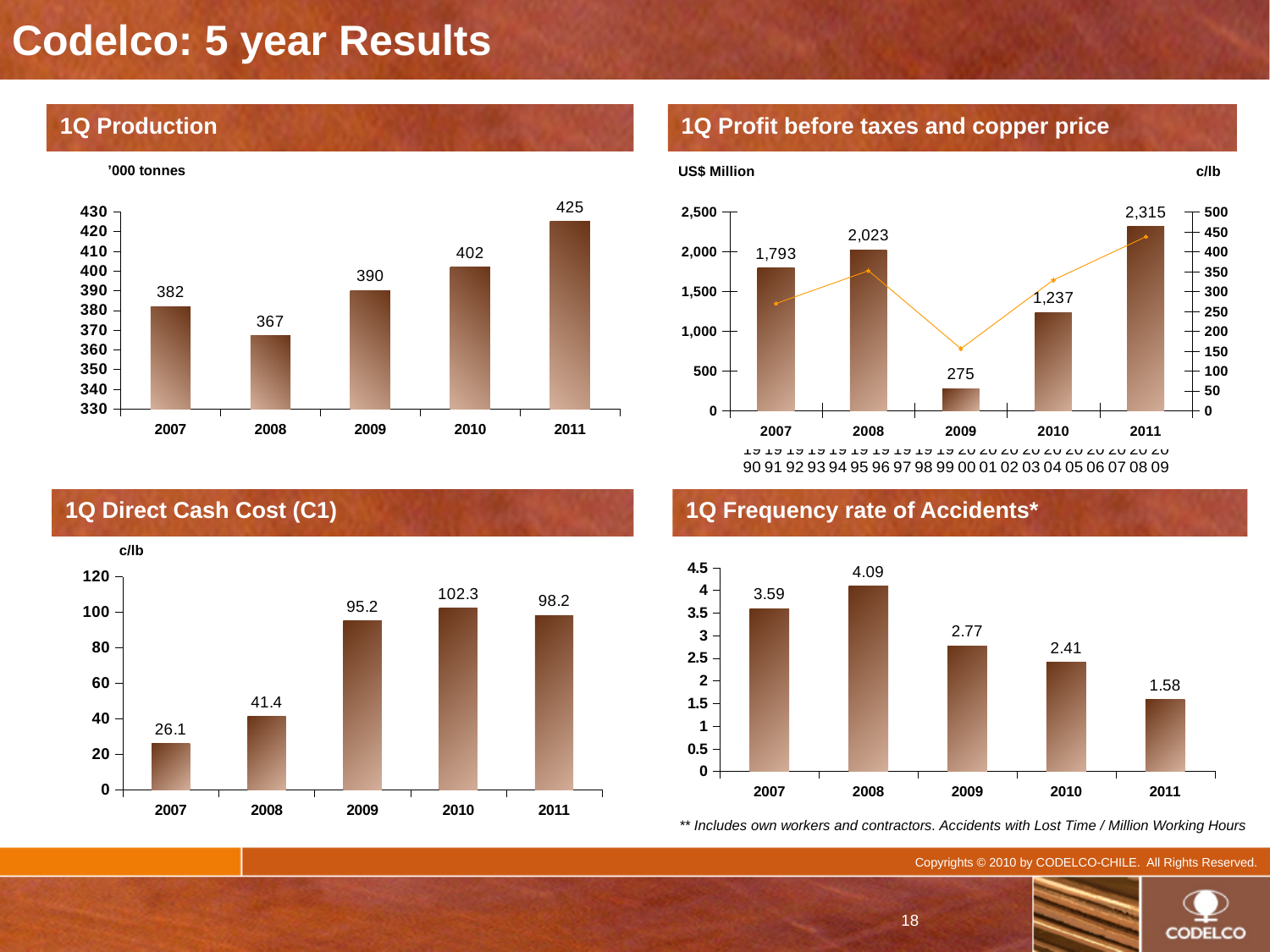
In the 1Q Profit before taxes and copper price chart, is the copper price for 2009 greater or less than 200 c/lb? less In the 1Q Profit before taxes and copper price chart, which year had the highest profit before taxes? 2011 In the 1Q Production chart, what is the difference between the 2011 and 2007 values? 43 How many years are shown on the x axis of the 1Q Frequency rate of Accidents chart? 5 In the 1Q Production chart, what was production in 2011? 425 In the 1Q Direct Cash Cost (C1) chart, what was the cash cost in 2010? 102.3 In the 1Q Production chart, which year had the lowest production? 2008 In the 1Q Frequency rate of Accidents chart, what was the rate in 2008? 4.09 In the 1Q Profit before taxes and copper price chart, what was profit before taxes in 2009? 275 In the 1Q Direct Cash Cost (C1) chart, which is larger, the 2009 value or the 2011 value? 2011 In the 1Q Direct Cash Cost (C1) chart, what is the difference between the 2008 and 2007 values? 15.3 In the 1Q Frequency rate of Accidents chart, do the values rise or fall from 2008 to 2011? fall